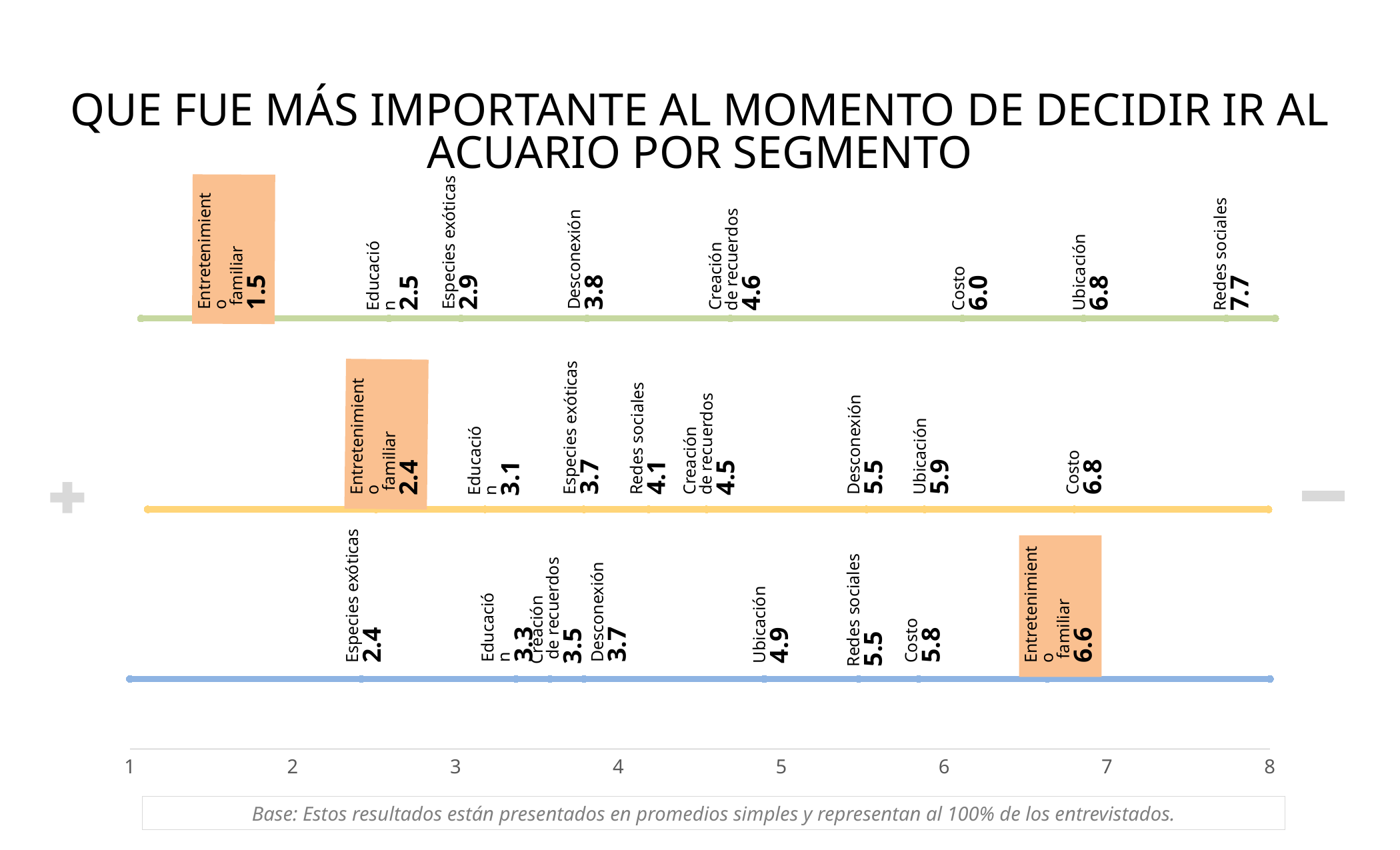
On the middle (yellow) line, which is larger: the value for Desconexión or the value for Redes sociales? Desconexión How many categories are plotted on the top (green) line? 8 How many horizontal lines (segments) are plotted on the chart? 3 On the top (green) line, what is the difference between the values for Redes sociales and Entretenimiento familiar? 6.2 On the bottom (blue) line, what is the difference between the values for Costo and Especies exóticas? 3.4 On the middle (yellow) line, what is the value for Costo? 6.8 On the bottom (blue) line, which category has the highest value? Entretenimiento familiar On the bottom (blue) line, what is the value for Entretenimiento familiar? 6.6 On the top (green) line, what is the value for Redes sociales? 7.7 On the middle (yellow) line, which category has the lowest value? Entretenimiento familiar What is the value for Ubicación on the top (green) line? 6.8 On the top (green) line, which category has the lowest value? Entretenimiento familiar